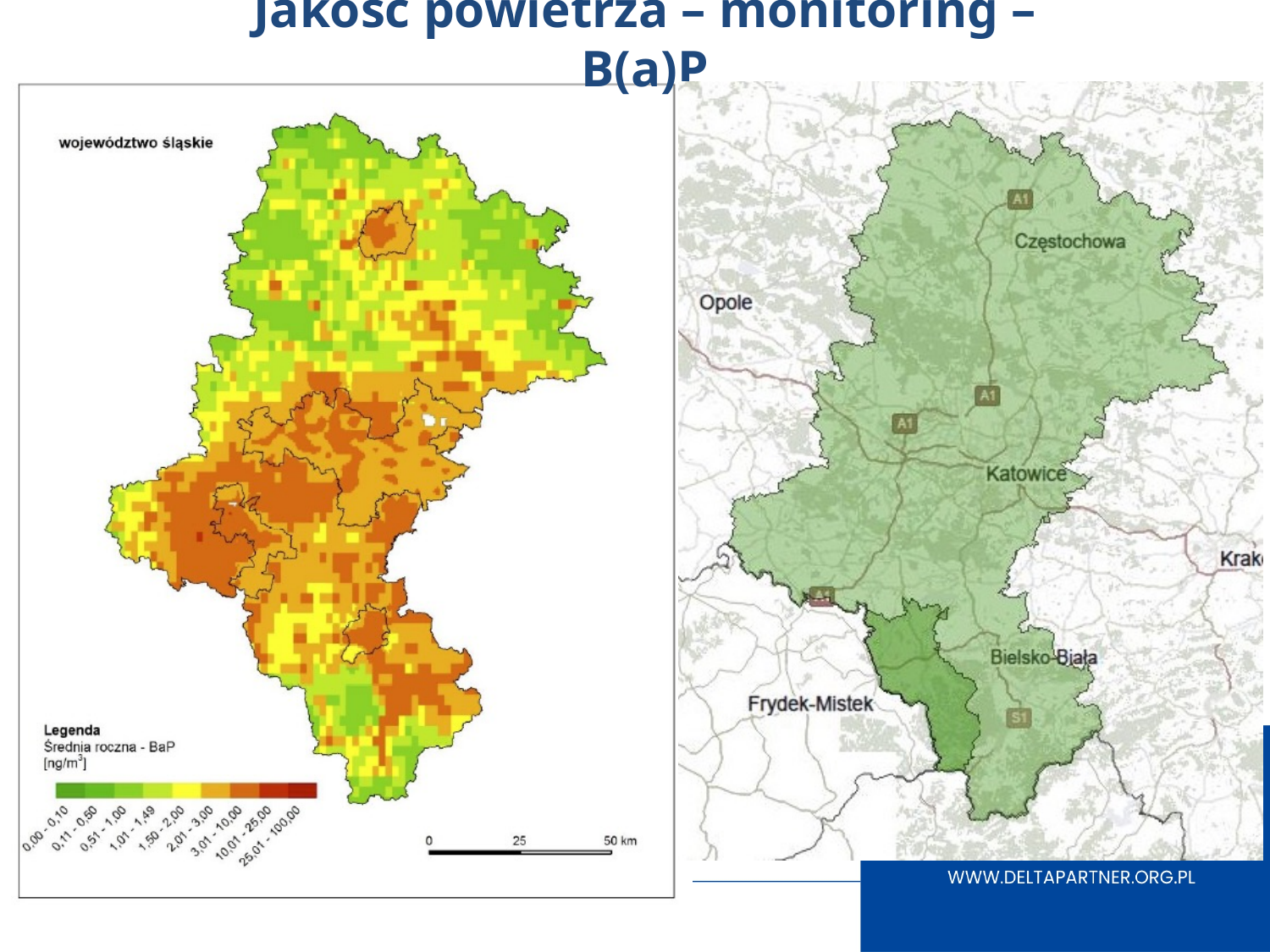
On the left map, how many colour classes does the legend list? 9 On the left map, what is the highest value range shown in the legend? 25,01 - 100,00 On the left map, what is the lowest value range shown in the legend? 0,00 - 0,10 On the left map, what unit is given in the legend for the annual average BaP? ng/m³ What kind of visualisation is shown on the left side of the slide? a map (colour-coded map of BaP concentration) On the left map, what is the maximum distance marked on the scale bar? 50 km